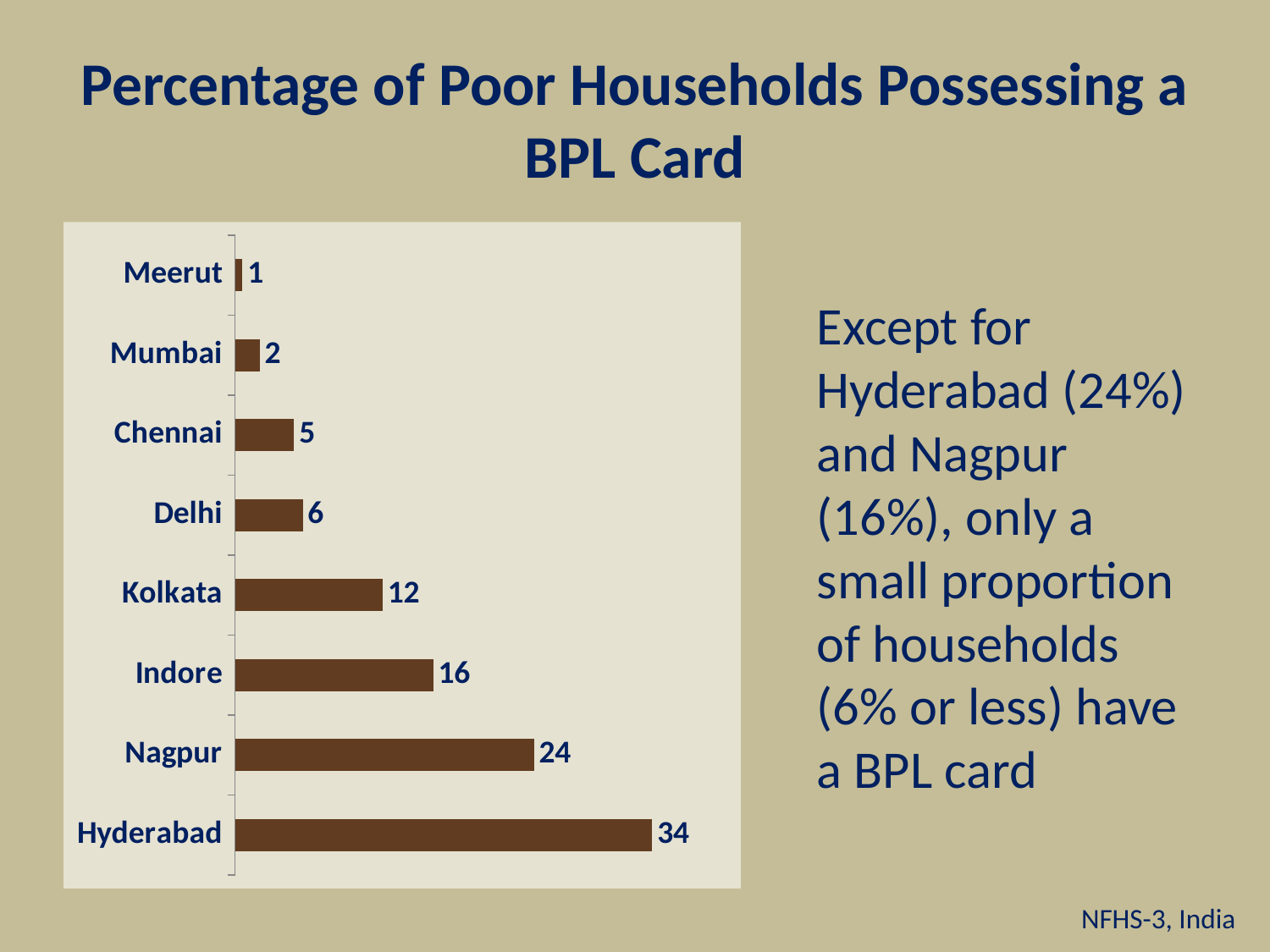
What is the title of the chart? Percentage of Poor Households Possessing a BPL Card What is the value for Hyderabad? 34 Which is larger, the value for Kolkata or the value for Indore? Indore What is the difference between the values for Indore and Delhi? 10 What is the value for Mumbai? 2 Which city has the lowest value? Meerut What kind of chart is shown on the slide? Bar chart How many cities are shown in the chart? 8 Which is larger, the value for Chennai or the value for Delhi? Delhi What is the difference between the values for Hyderabad and Nagpur? 10 What is the value for Kolkata? 12 Which city has the highest value? Hyderabad